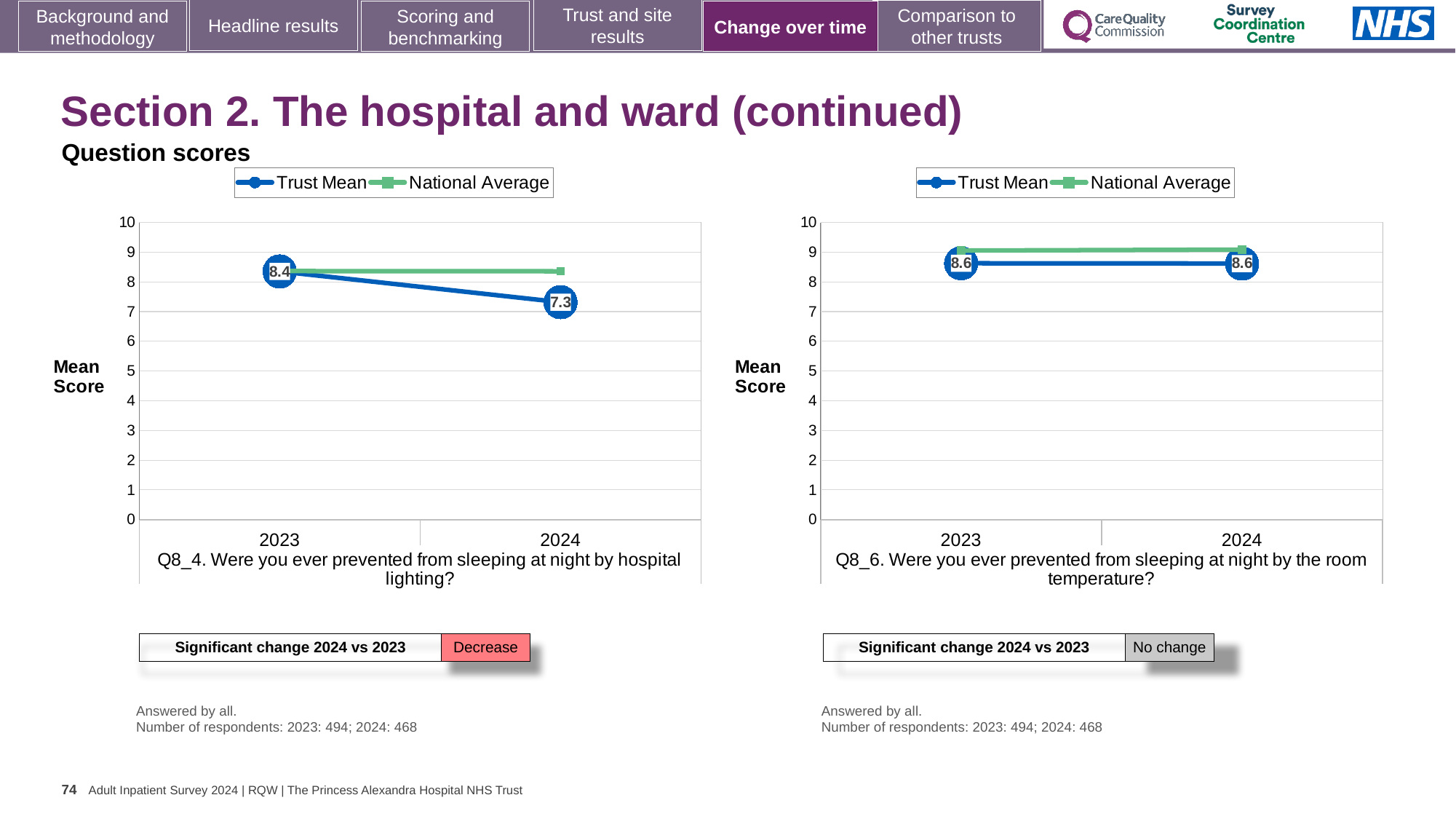
In the left chart (Q8_4), is the National Average for 2024 greater or less than 8? greater In the left chart (Q8_4), what is the Trust Mean score for 2024? 7.3 In the right chart (Q8_6), is the National Average for 2024 greater or less than 8? greater In the right chart (Q8_6), does the Trust Mean rise, fall or stay the same from 2023 to 2024? stay the same How many series does the legend of the left chart (Q8_4) list? 2 In the left chart (Q8_4), which year has the higher Trust Mean score, 2023 or 2024? 2023 In the right chart (Q8_6), what is the Trust Mean score for 2024? 8.6 In the left chart (Q8_4), does the Trust Mean rise or fall from 2023 to 2024? fall What significant change result is shown below the left chart (Q8_4) for 2024 vs 2023? Decrease In the left chart (Q8_4), by how much did the Trust Mean score fall from 2023 to 2024? 1.1 What type of chart is used for Q8_6 on the right? line chart In the left chart (Q8_4), what is the Trust Mean score for 2023? 8.4